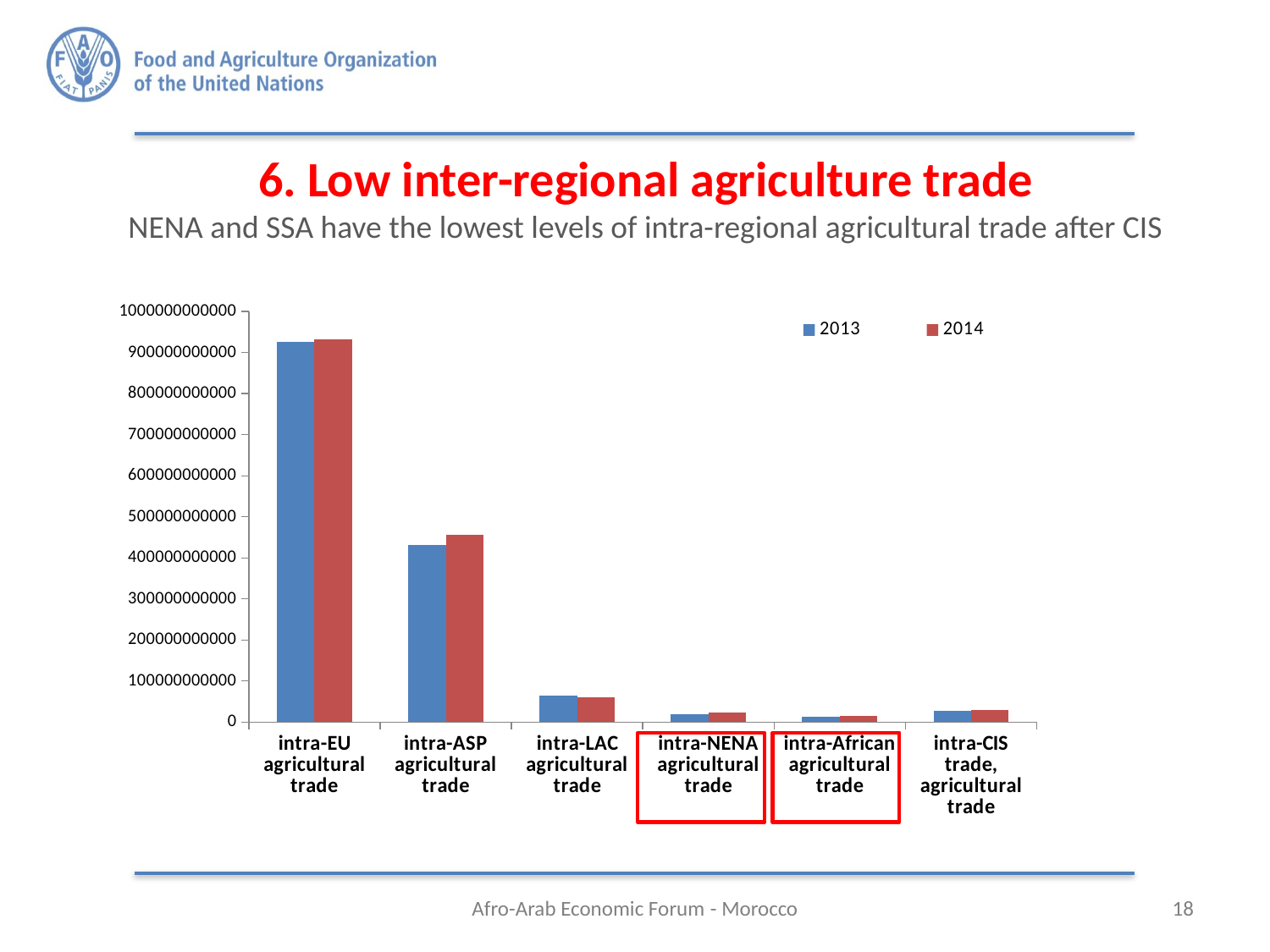
Which category has the lowest values in the chart? intra-African agricultural trade For intra-ASP agricultural trade, which year has the larger value, 2013 or 2014? 2014 Is the 2014 value for intra-EU agricultural trade greater or less than 900000000000? greater How many series does the chart's legend list? 2 Which colour represents the 2014 series in the chart? red Which is larger, the 2013 value for intra-EU agricultural trade or the 2013 value for intra-ASP agricultural trade? intra-EU agricultural trade Is the 2013 value for intra-LAC agricultural trade greater or less than 100000000000? less What kind of chart is shown on the slide? bar chart How many categories are shown on the x axis of the chart? 6 Is the 2013 value for intra-ASP agricultural trade greater or less than 500000000000? less Which two categories are highlighted with red boxes on the chart? intra-NENA agricultural trade and intra-African agricultural trade Which category has the highest values in the chart? intra-EU agricultural trade